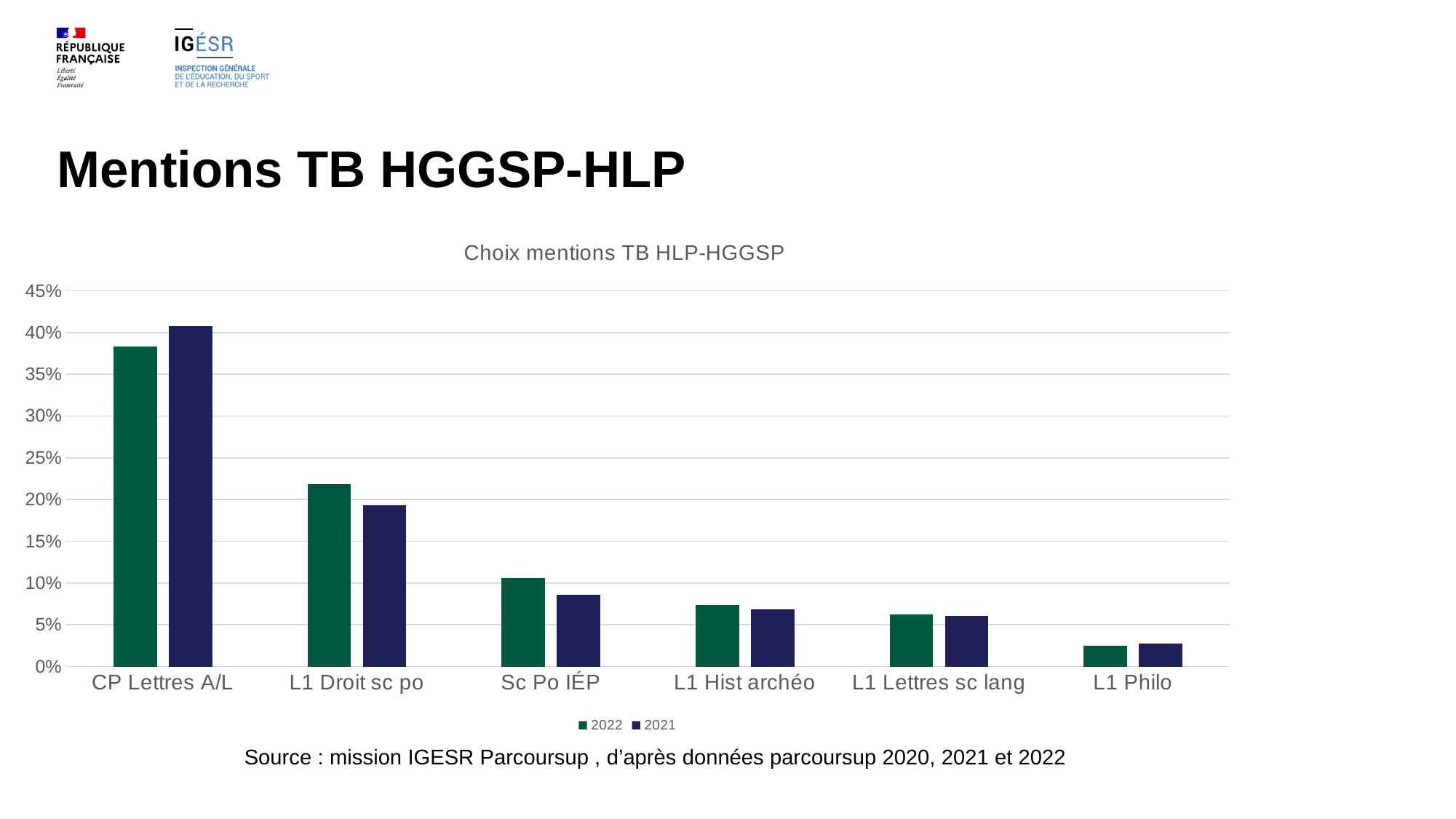
Is the 2022 value for L1 Droit sc po greater or less than 20%? greater Which category has the lowest value for the 2022 series? L1 Philo Which category has the highest value for the 2022 series? CP Lettres A/L How many categories are shown on the x axis of the chart? 6 For CP Lettres A/L, which series has the larger value, 2022 or 2021? 2021 For L1 Droit sc po, which series has the larger value, 2022 or 2021? 2022 Is the 2021 value for CP Lettres A/L greater or less than 35%? greater What is the title of the chart? Choix mentions TB HLP-HGGSP Do the 2022 values rise or fall moving from left to right along the x axis? fall How many series does the chart's legend list? 2 What kind of chart is shown on the slide? bar chart Is the 2021 value for Sc Po IÉP greater or less than 10%? less